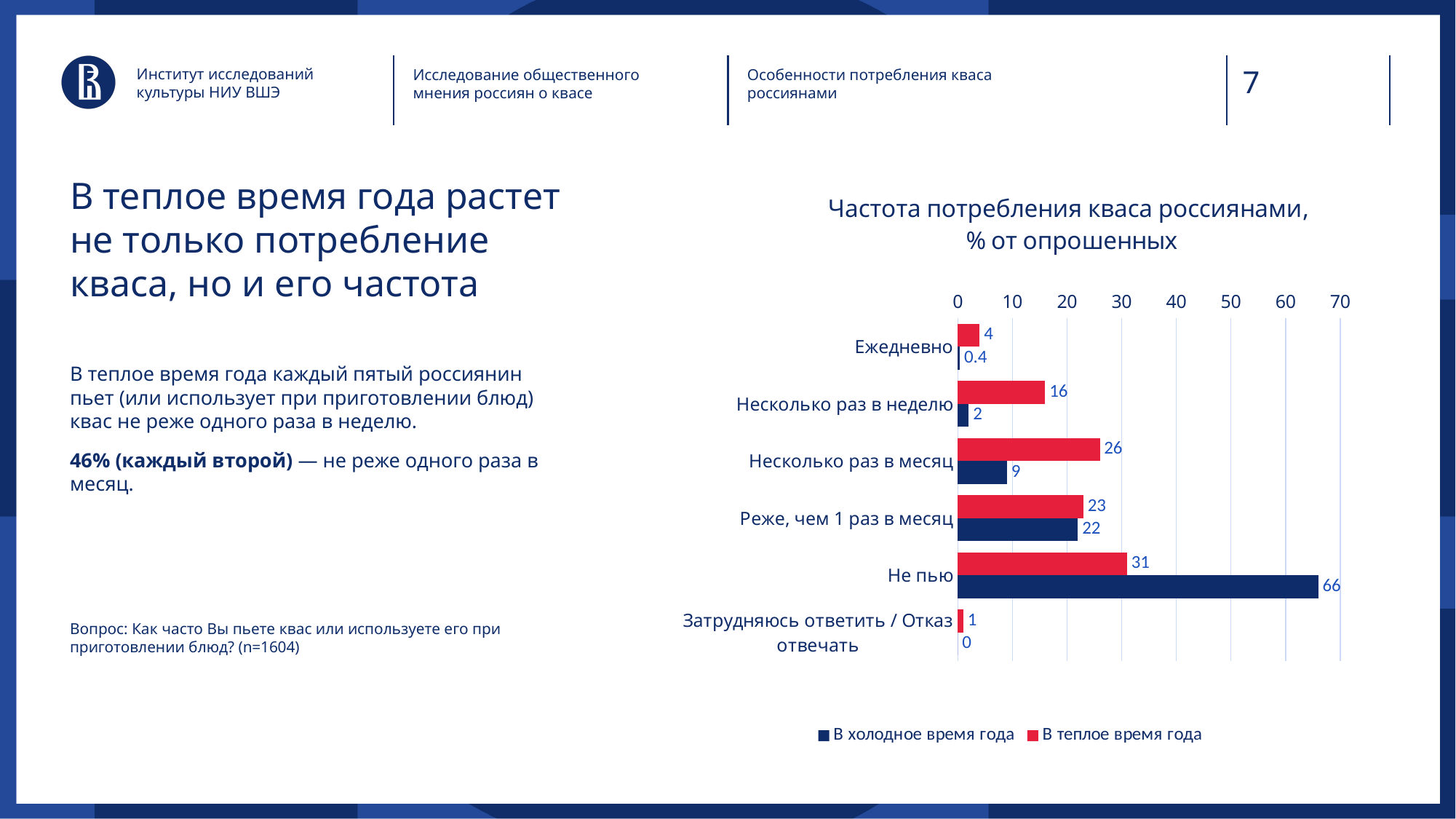
For 'Несколько раз в неделю', which series has the larger value: 'В холодное время года' or 'В теплое время года'? В теплое время года What kind of chart is shown on the slide? Bar chart How many series does the legend list? 2 What is the difference between the 'В холодное время года' and 'В теплое время года' values for 'Не пью'? 35 Which category has the lowest value in the 'В холодное время года' series? Затрудняюсь ответить / Отказ отвечать What is the value for 'Не пью' in the 'В холодное время года' series? 66 What is the value for 'Несколько раз в месяц' in the 'В теплое время года' series? 26 Which colour represents the 'В теплое время года' series? Red What is the value for 'Ежедневно' in the 'В холодное время года' series? 0.4 What is the title of the chart? Частота потребления кваса россиянами, % от опрошенных Which category has the highest value in the 'В теплое время года' series? Не пью How many categories are shown on the chart? 6